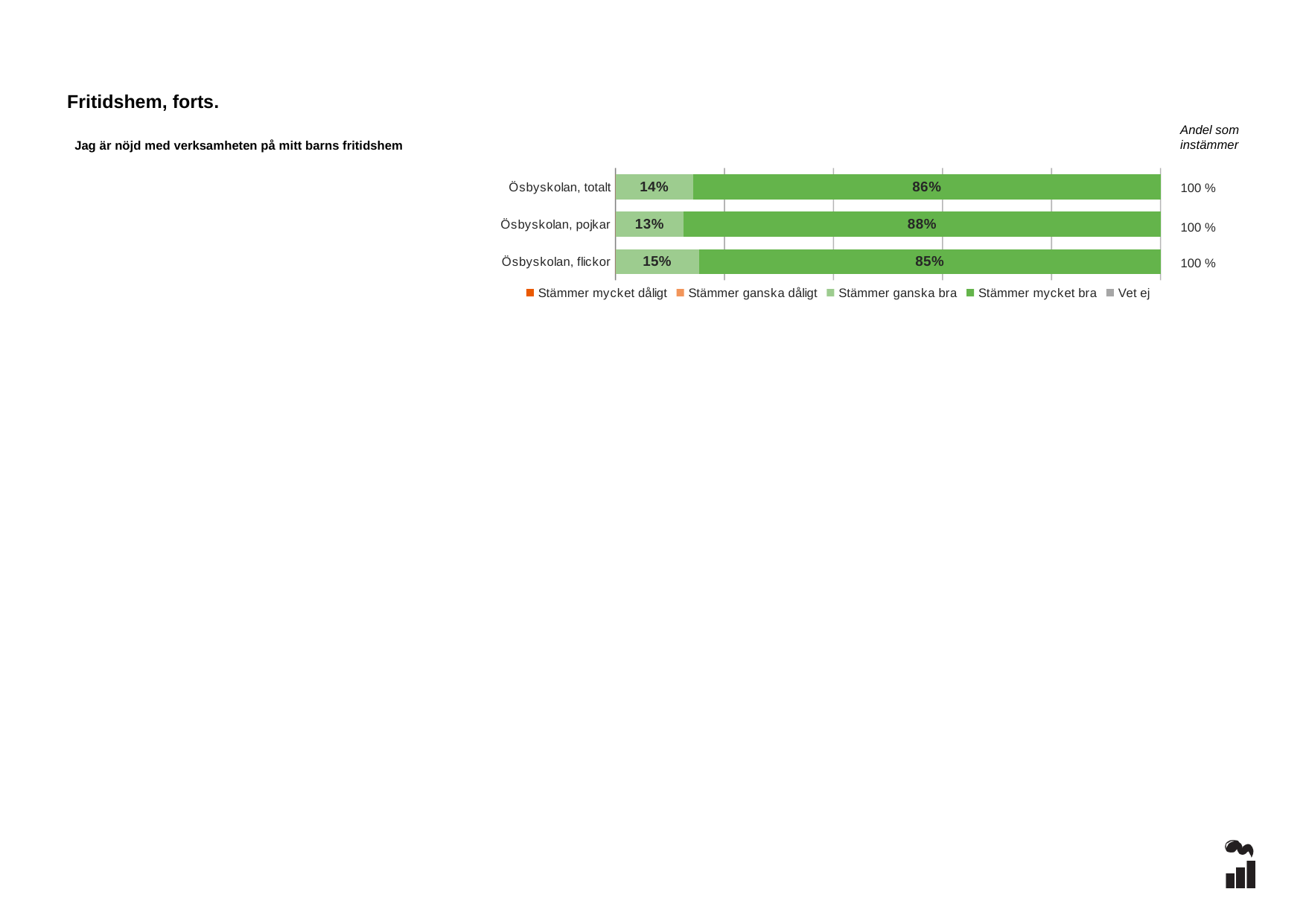
What is the value of "Stämmer ganska bra" for Ösbyskolan, flickor? 15% What kind of chart is shown on the slide? Stacked bar chart How many series does the legend list? 5 What is the difference between the "Stämmer mycket bra" values for Ösbyskolan, pojkar and Ösbyskolan, flickor? 3% How many categories are shown on the chart? 3 What is the value of "Stämmer mycket bra" for Ösbyskolan, flickor? 85% Which category has the lowest value for "Stämmer ganska bra"? Ösbyskolan, pojkar What is the value of "Stämmer ganska bra" for Ösbyskolan, pojkar? 13% What is the "Andel som instämmer" value shown for Ösbyskolan, pojkar? 100 % Which category has the highest value for "Stämmer mycket bra"? Ösbyskolan, pojkar Which is larger: "Stämmer ganska bra" for Ösbyskolan, flickor or for Ösbyskolan, totalt? Ösbyskolan, flickor What is the value of "Stämmer mycket bra" for Ösbyskolan, totalt? 86%